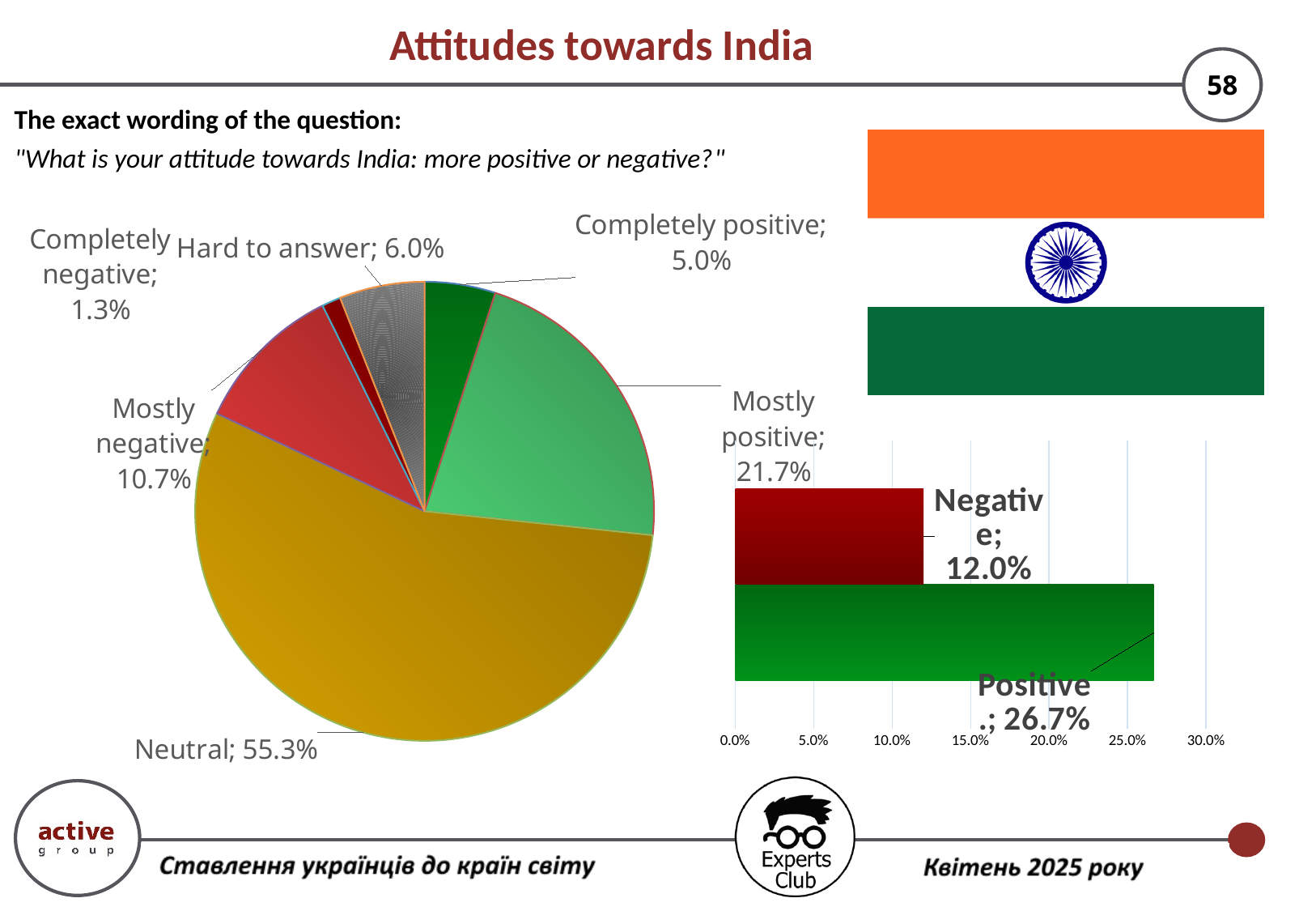
In the pie chart, which category has the largest slice? Neutral In the bar chart on the right, what is the difference between "Positive" and "Negative"? 14.7% In the pie chart, which category has the smallest slice? Completely negative In the pie chart, how many categories are shown? 6 In the pie chart, what is the value for "Mostly positive"? 21.7% What type of chart is shown on the right side of the slide? Bar chart In the pie chart, what is the difference between "Mostly positive" and "Mostly negative"? 11.0% In the pie chart, what is the value for "Completely negative"? 1.3% In the bar chart on the right, what is the value for "Positive"? 26.7% In the pie chart, what share of respondents answered "Neutral"? 55.3% In the bar chart on the right, what is the value for "Negative"? 12.0% In the pie chart, which is larger: "Hard to answer" or "Completely positive"? Hard to answer